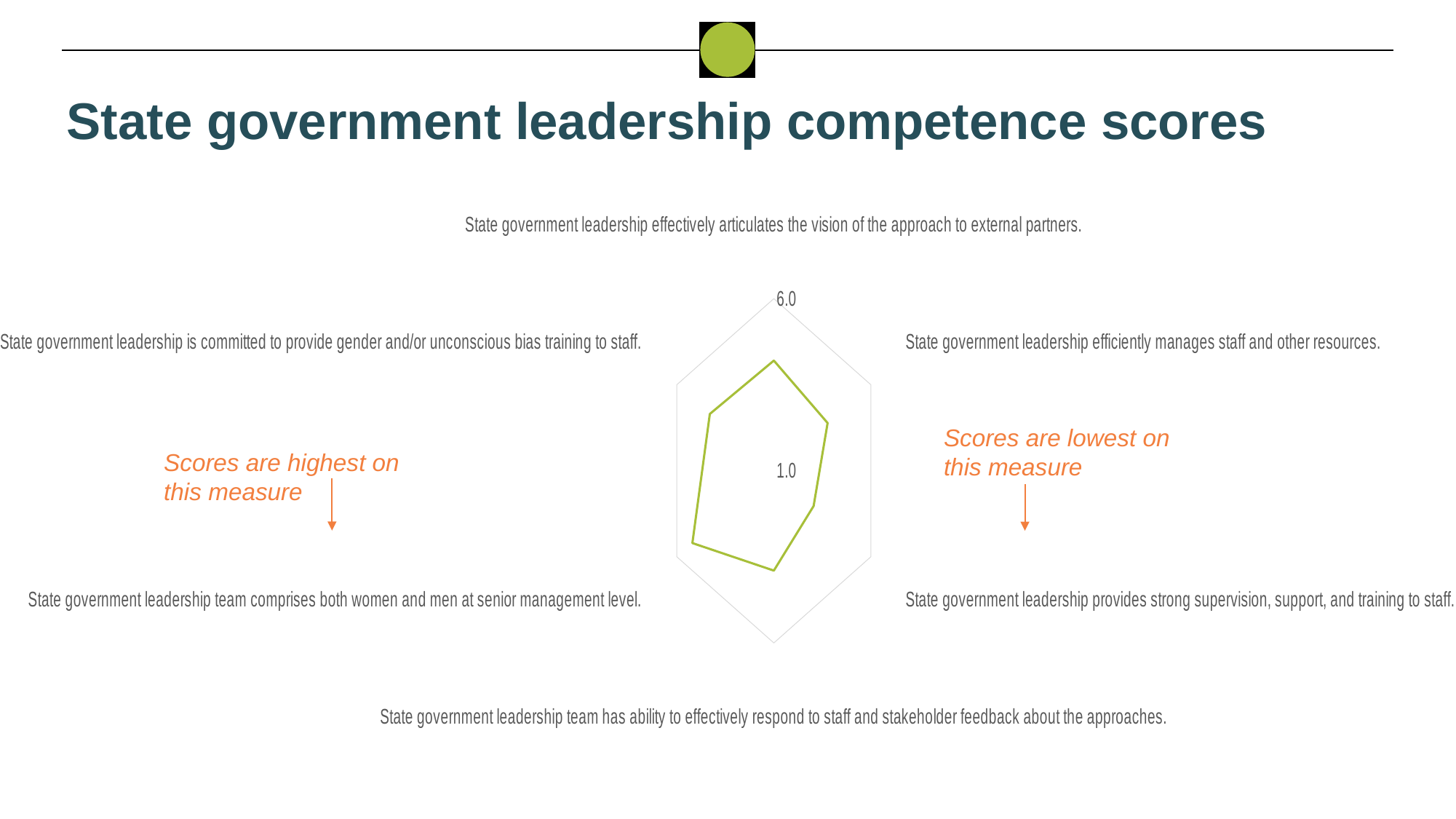
Which has the larger score: 'efficiently manages staff and other resources' or 'team comprises both women and men at senior management level'? State government leadership team comprises both women and men at senior management level. Which measure is plotted at the top of the radar chart? State government leadership effectively articulates the vision of the approach to external partners. On which measure are the scores highest, according to the slide? State government leadership team comprises both women and men at senior management level. What is the title of the slide's chart? State government leadership competence scores Is the score for 'provides strong supervision, support, and training to staff' greater or less than 6.0? less On which measure are the scores lowest, according to the slide? State government leadership provides strong supervision, support, and training to staff. How many measures (axes) does the radar chart have? 6 What is the highest value shown on the radar chart's axis scale? 6.0 Which has the larger score: 'effectively articulates the vision of the approach to external partners' or 'provides strong supervision, support, and training to staff'? State government leadership effectively articulates the vision of the approach to external partners. What kind of chart is shown on the slide? Radar chart